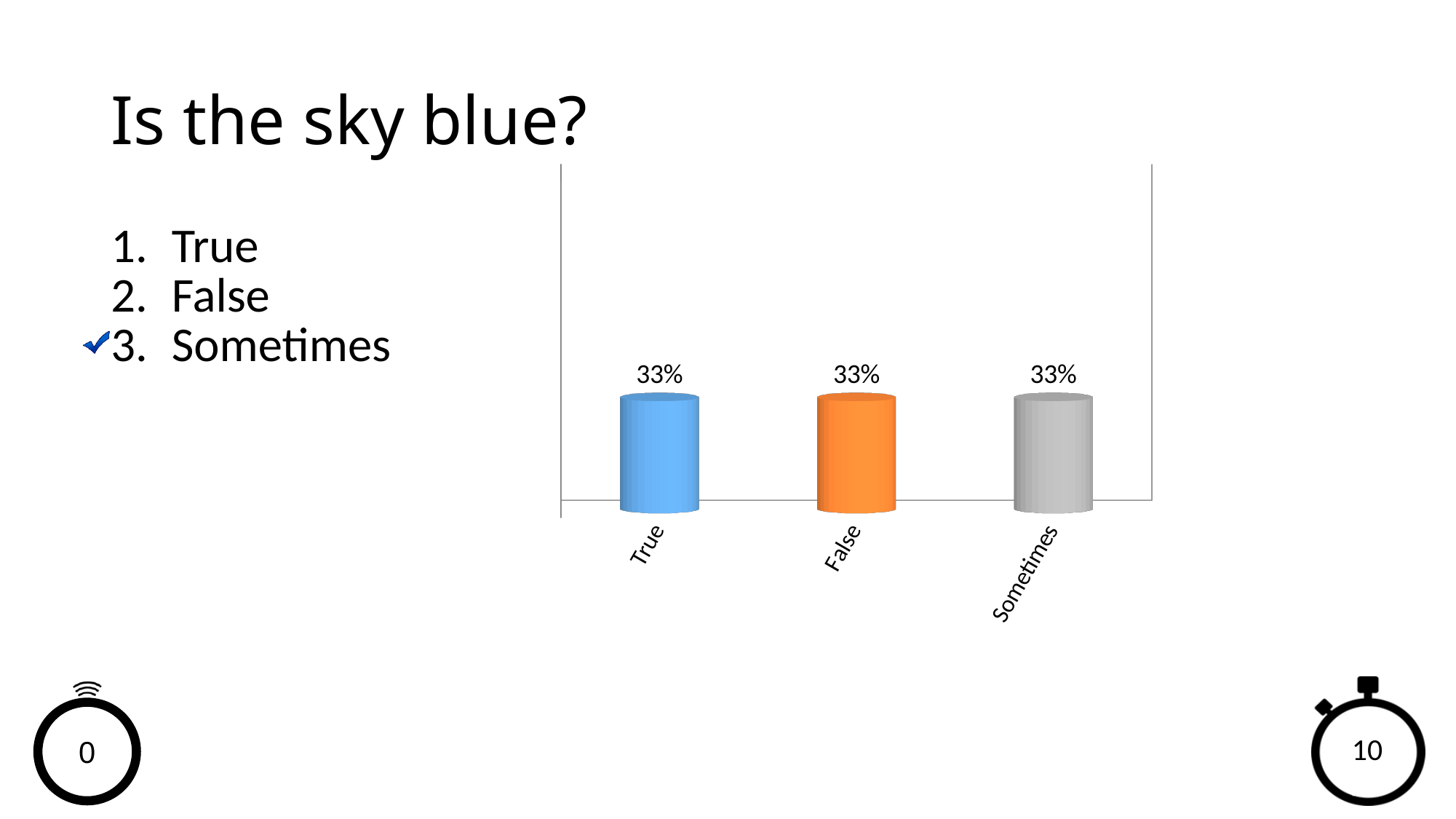
What is the value shown for False? 33% What is the value shown for Sometimes? 33% What is the value shown for True? 33% What colour is the bar for False? orange How many categories are plotted on the chart? 3 What kind of chart is shown on the slide? bar chart Do the values rise, fall, or stay the same across the categories from left to right? stay the same Which category is plotted in the middle of the chart? False What is the difference between the values for True and False? 0%